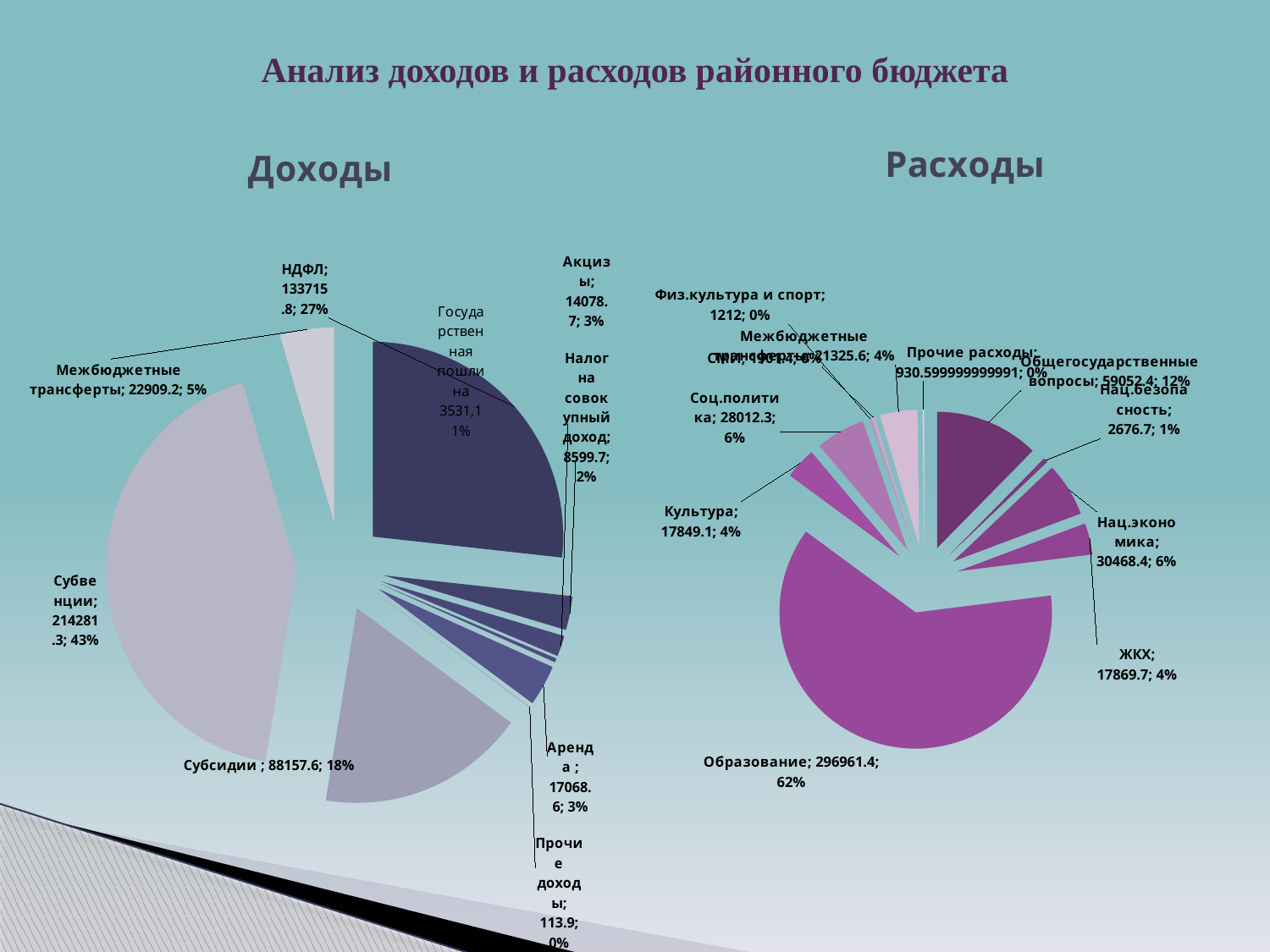
In the "Доходы" chart, what value is shown for Субвенции? 214281.3 In the "Расходы" chart, which is larger: Нац.экономика or Соц.политика? Нац.экономика What is the title of the slide? Анализ доходов и расходов районного бюджета In the "Расходы" chart, what value is shown for Образование? 296961.4 In the "Доходы" chart, which category has the largest slice? Субвенции In the "Доходы" chart, which is larger: Субсидии or Межбюджетные трансферты? Субсидии What type of chart is used for the "Доходы" chart? pie chart In the "Доходы" chart, what is the difference between the values for Акцизы and Аренда? 2989.9 In the "Расходы" chart, what share of the pie does Общегосударственные вопросы represent? 12% In the "Доходы" chart, which category has the smallest value? Прочие доходы In the "Доходы" chart, what share of the pie does НДФЛ represent? 27% In the "Расходы" chart, which category has the largest slice? Образование